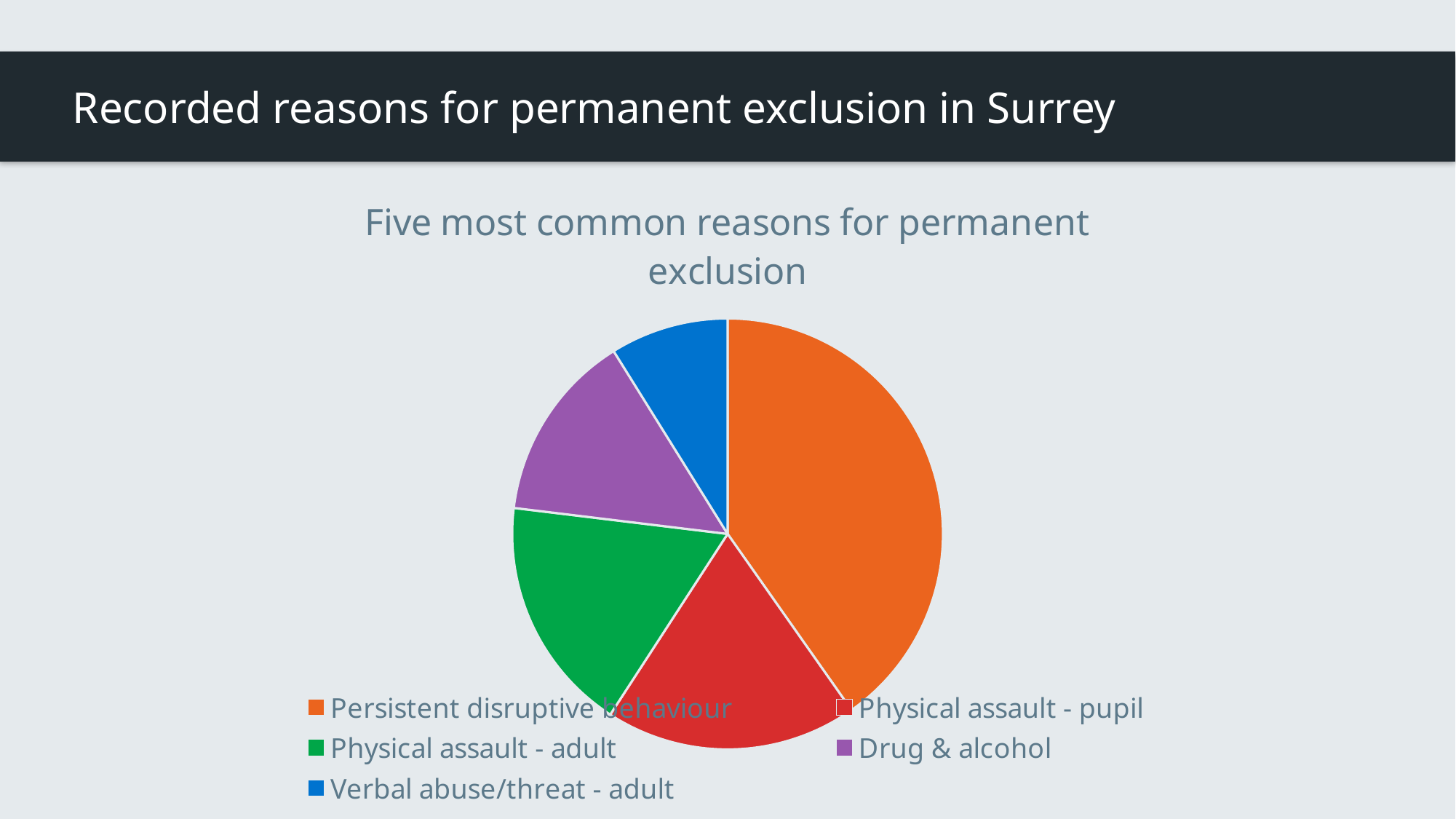
What is the title of the pie chart? Five most common reasons for permanent exclusion How many slices does the pie chart have? 5 Which slice is larger: Drug & alcohol or Verbal abuse/threat - adult? Drug & alcohol Which reason is shown in green in the pie chart? Physical assault - adult Which slice is larger: Physical assault - pupil or Drug & alcohol? Physical assault - pupil What kind of chart is shown on the slide? Pie chart Which slice is larger: Physical assault - adult or Verbal abuse/threat - adult? Physical assault - adult Which reason has the largest slice of the pie chart? Persistent disruptive behaviour Which reason has the smallest slice of the pie chart? Verbal abuse/threat - adult